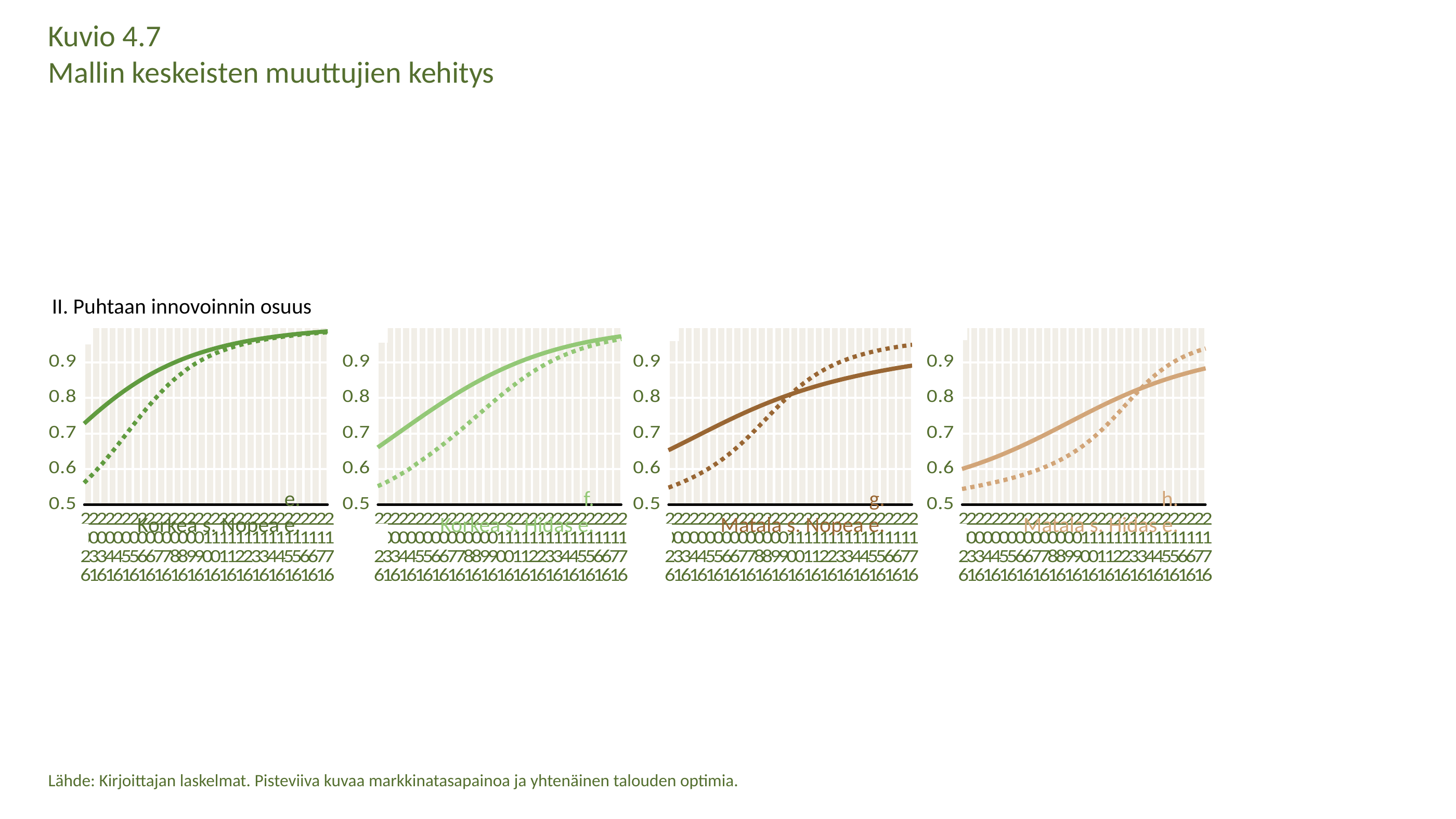
In the chart labelled g. (Matala s. Nopea e.), is the starting value of the solid line greater or less than 0.6? greater In the chart labelled g. (Matala s. Nopea e.), which line is higher at the right end of the x axis, the solid line or the dotted line? dotted line According to the note at the bottom of the slide, what does the dotted line represent? markkinatasapainoa In the chart labelled e. (Korkea s. Nopea e.), is the starting value of the solid line greater or less than 0.7? greater How many lines are plotted in the chart labelled h. (Matala s. Hidas e.)? 2 How many charts are shown under the heading 'II. Puhtaan innovoinnin osuus'? 4 In the chart labelled g. (Matala s. Nopea e.), is the final value of the dotted line greater or less than 0.9? greater In the chart labelled e. (Korkea s. Nopea e.), which line is higher at the left end of the x axis, the solid line or the dotted line? solid line What kind of chart is the chart labelled e. (Korkea s. Nopea e.)? line chart In the chart labelled e. (Korkea s. Nopea e.), do the lines rise or fall along the x axis? rise